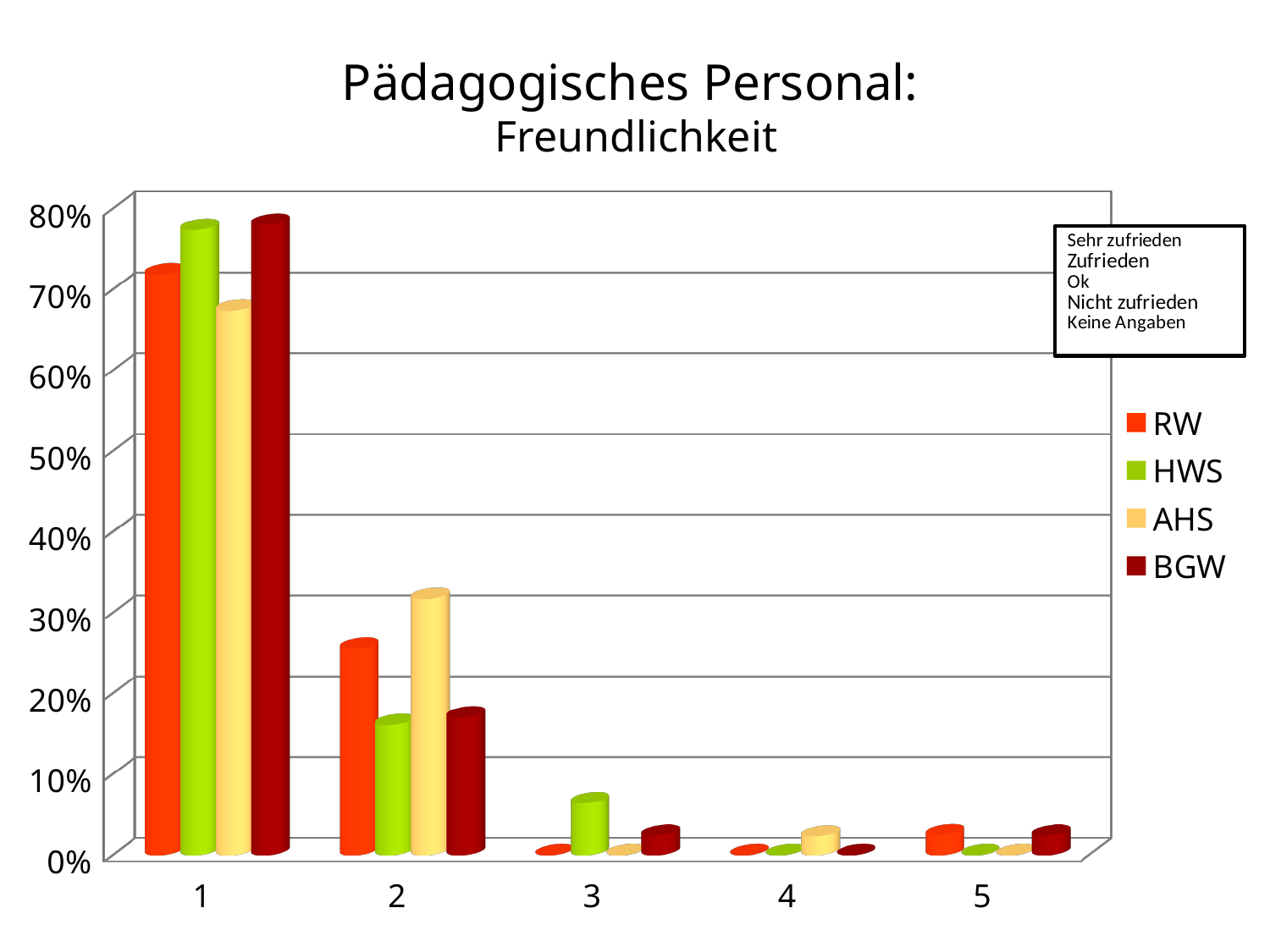
Is the value for HWS in category 1 greater or less than 70%? greater Which series has the lowest value in category 1? AHS Is the value for RW in category 2 greater or less than 30%? less Is the value for AHS in category 1 greater or less than 70%? less In category 2, which is larger, the value for RW or the value for HWS? RW What kind of chart is shown on the slide? bar chart How many categories are shown on the x axis? 5 Do the HWS values rise or fall from category 1 to category 2? fall Which series has the highest value in category 3? HWS Which series has the highest value in category 2? AHS How many series does the legend list? 4